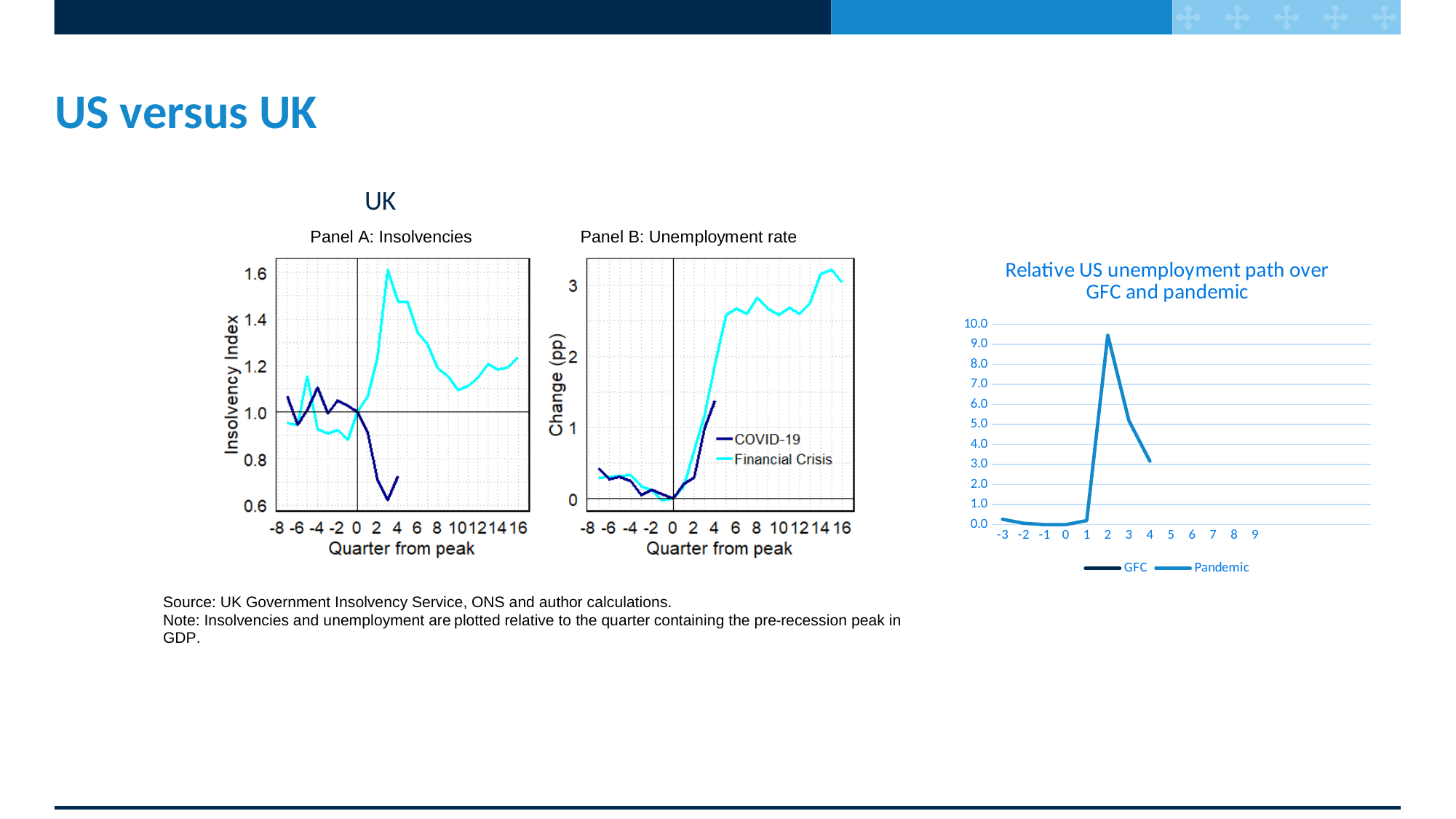
What is the x-axis label of the UK Panel B: Unemployment rate chart? Quarter from peak How many quarter labels are shown on the x axis of the 'Relative US unemployment path over GFC and pandemic' chart? 13 In the 'Relative US unemployment path over GFC and pandemic' chart, is the Pandemic value at quarter 4 greater or less than 4.0? less In the 'Relative US unemployment path over GFC and pandemic' chart, at which quarter does the Pandemic line reach its highest value? 2 In the UK Panel A: Insolvencies chart, which series has the higher value at quarter 3, COVID-19 or Financial Crisis? Financial Crisis In the 'Relative US unemployment path over GFC and pandemic' chart, does the Pandemic line rise or fall between quarter 2 and quarter 4? fall In the UK Panel A: Insolvencies chart, is the COVID-19 value at quarter 3 greater or less than 0.8? less How many series does the legend of the 'Relative US unemployment path over GFC and pandemic' chart list? 2 In the UK Panel A: Insolvencies chart, is the Financial Crisis value at quarter 16 greater or less than 1.2? greater What kind of chart is the 'Relative US unemployment path over GFC and pandemic' chart? line chart